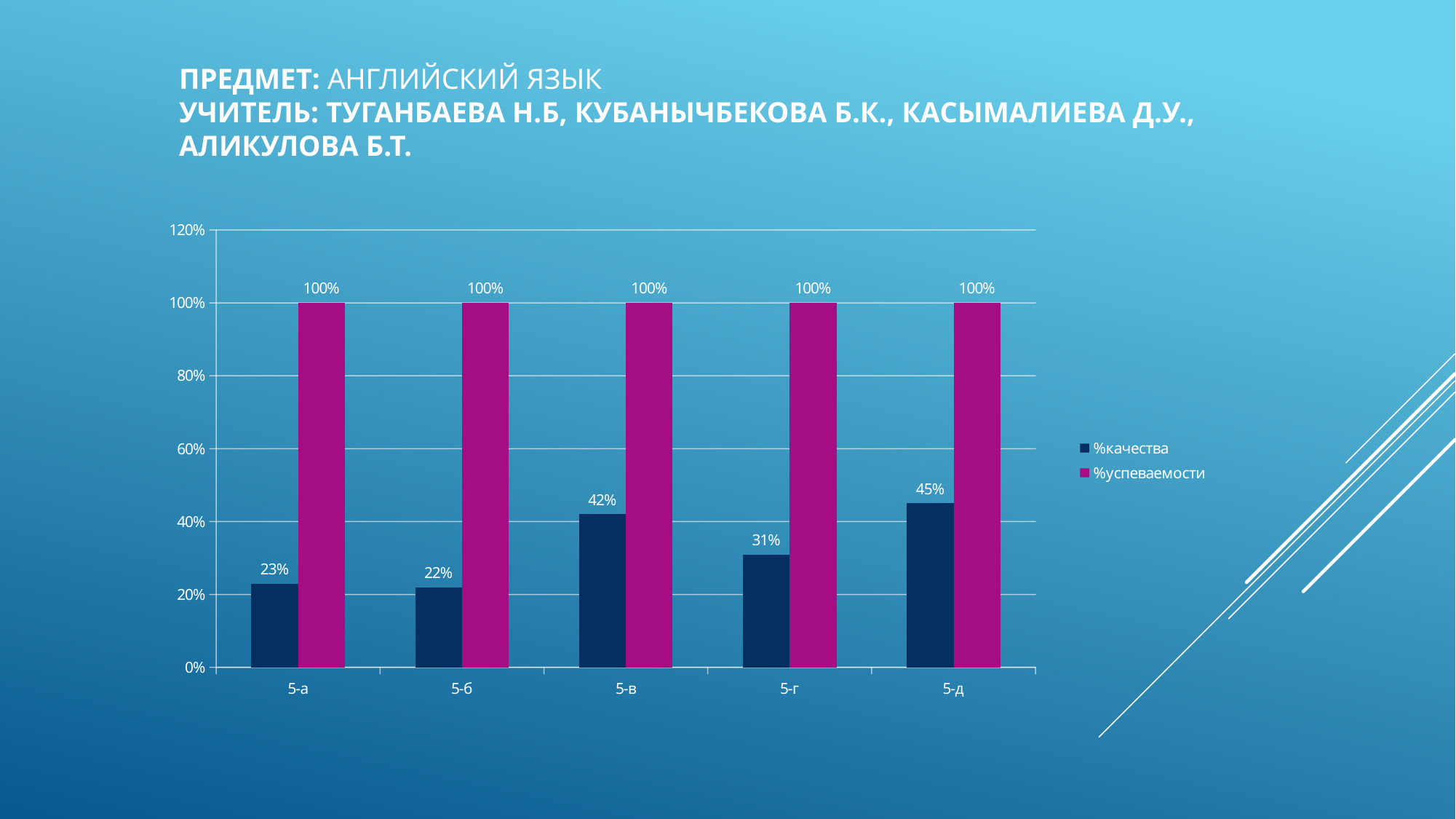
What is the %качества value for class 5-в? 42% Which class has the lowest %качества? 5-б What is the %качества value for class 5-г? 31% What is the difference between the %качества values for 5-д and 5-а? 22% How many classes are shown on the x axis? 5 How many series does the legend list? 2 What is the %успеваемости value for class 5-б? 100% Is the %качества value for 5-д greater or less than 40%? greater What kind of chart is shown on the slide? bar chart Which class has a higher %качества, 5-в or 5-г? 5-в Which colour represents %успеваемости in the legend? magenta Which class has the highest %качества? 5-д